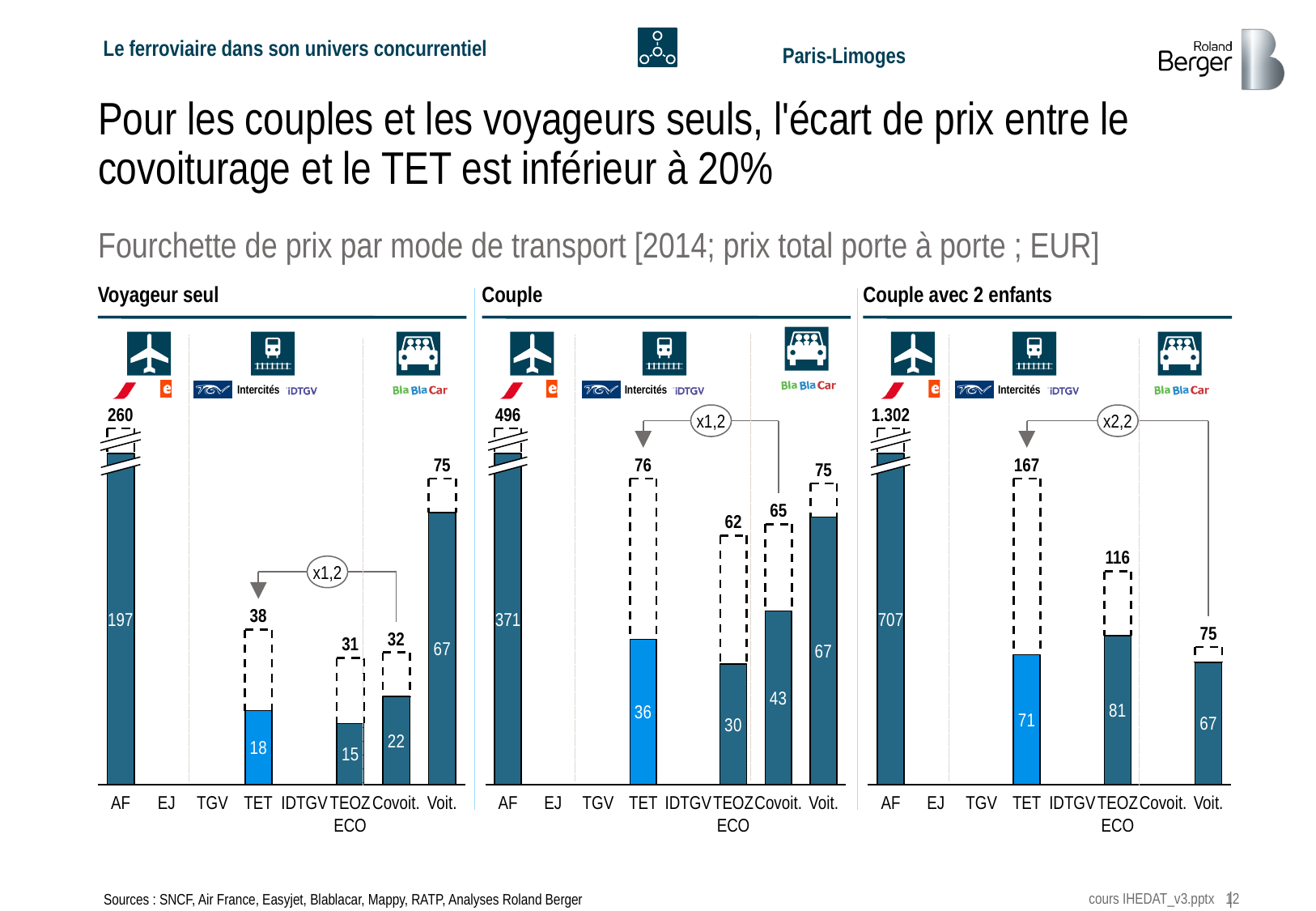
In the 'Couple avec 2 enfants' chart, what is the minimum price shown for TEOZ ECO? 81 In the 'Voyageur seul' chart, what is the maximum price shown for AF? 260 In the 'Couple avec 2 enfants' chart, which is larger: the minimum price for TET or the minimum price for Voit.? TET In the 'Voyageur seul' chart, what multiplier is shown between TET and Covoit.? x1,2 In the 'Couple avec 2 enfants' chart, what multiplier is shown in the circle above the bars? x2,2 In the 'Voyageur seul' chart, what is the minimum price shown for TET? 18 In the 'Couple' chart, which mode has the highest maximum price? AF What kind of chart is used on this slide? bar chart In the 'Voyageur seul' chart, which mode has the lowest minimum price? TEOZ ECO In the 'Couple' chart, what is the difference between the maximum price for TET and the maximum price for Covoit.? 11 In the 'Couple' chart, what is the maximum price shown for Covoit.? 65 In the 'Couple avec 2 enfants' chart, what is the maximum price shown for AF? 1.302